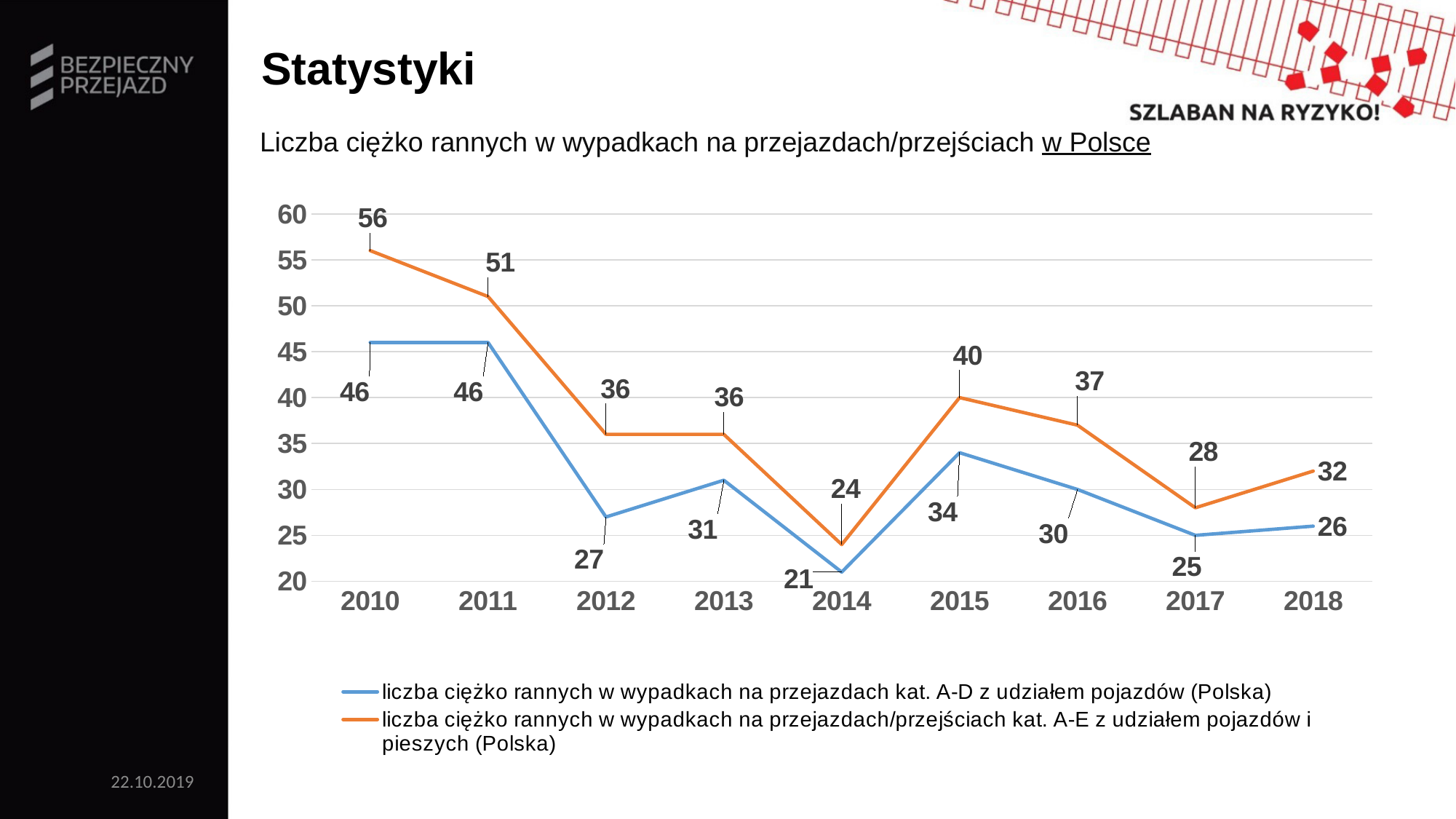
How many years are shown on the x axis? 9 What is the value of the orange series (kat. A-E z udziałem pojazdów i pieszych) in 2010? 56 What is the difference between the orange and blue series values in 2012? 9 Which is larger: the blue series value in 2013 or the blue series value in 2016? 2013 What kind of chart is shown on the slide? line chart Does the orange series rise or fall from 2010 to 2014? fall How many series does the legend list? 2 What is the value of the orange series (kat. A-E z udziałem pojazdów i pieszych) in 2015? 40 In which year is the blue series (kat. A-D) at its lowest? 2014 In which year is the orange series (kat. A-E) at its highest? 2010 What is the value of the blue series (kat. A-D z udziałem pojazdów) in 2014? 21 What is the value of the blue series (kat. A-D z udziałem pojazdów) in 2018? 26